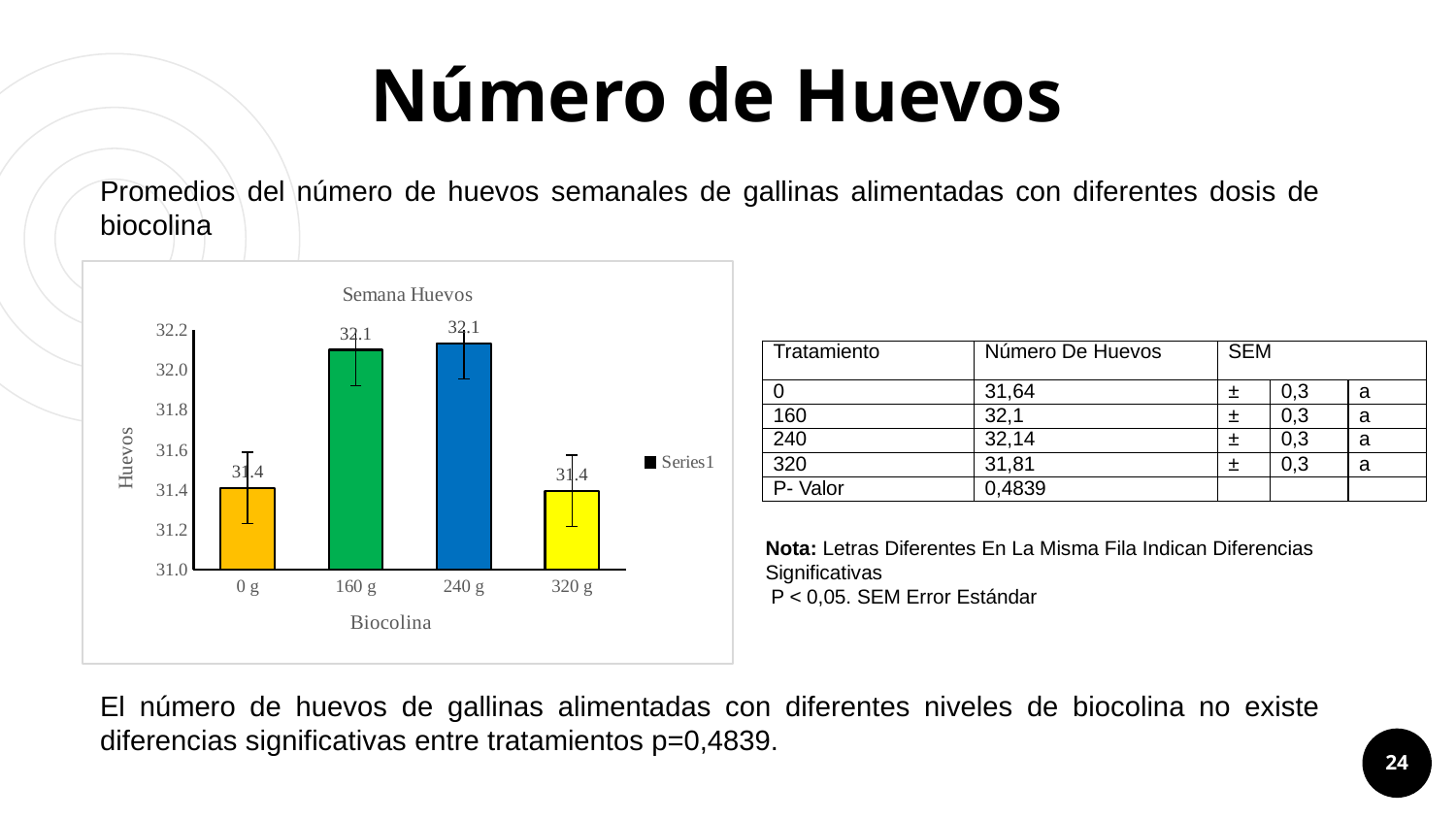
What is the value for 0 g in the Semana Huevos chart? 31.4 Is the value for 240 g in the Semana Huevos chart greater or less than 32.0? greater What is the title of the x axis in the Semana Huevos chart? Biocolina How many categories are shown on the x axis of the Semana Huevos chart? 4 What is the value for 320 g in the Semana Huevos chart? 31.4 Is the value for 0 g in the Semana Huevos chart greater or less than 31.6? less What is the value for 160 g in the Semana Huevos chart? 32.1 How many series does the legend of the Semana Huevos chart list? 1 What kind of chart is the Semana Huevos chart? bar chart Which is larger in the Semana Huevos chart, the value for 160 g or the value for 320 g? 160 g What is the value for 240 g in the Semana Huevos chart? 32.1 What is the difference between the values for 240 g and 0 g in the Semana Huevos chart? 0.7